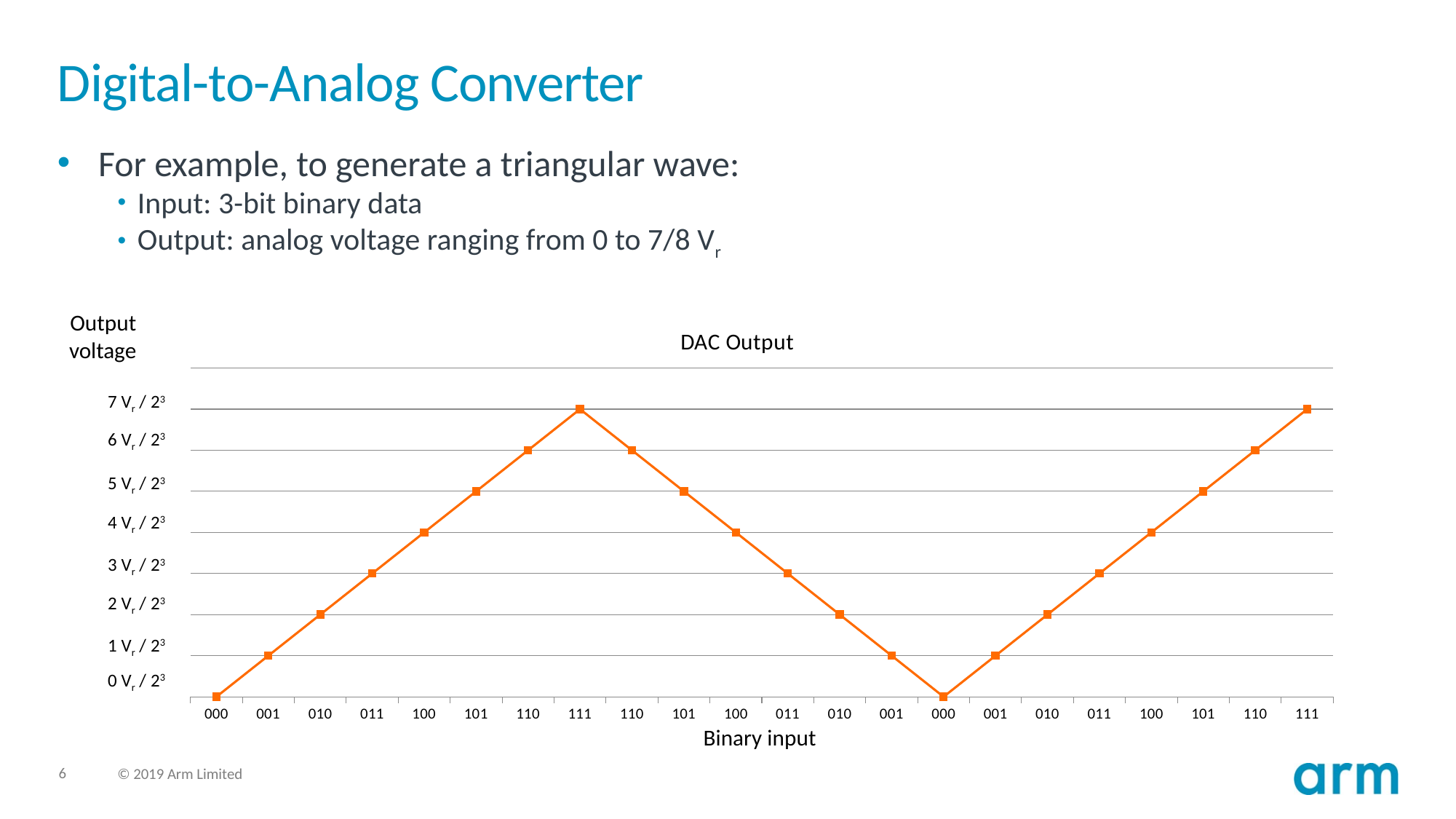
Which binary input gives the lowest output voltage on the DAC Output chart? 000 What output voltage does the binary input 000 produce on the DAC Output chart? 0 Vr / 2³ What output voltage does the binary input 100 produce on the DAC Output chart? 4 Vr / 2³ Which binary input produces a larger output voltage, 101 or 010? 101 What output voltage does the binary input 111 produce on the DAC Output chart? 7 Vr / 2³ What output voltage does the binary input 011 produce on the DAC Output chart? 3 Vr / 2³ What is the x-axis label of the DAC Output chart? Binary input Which binary input gives the highest output voltage on the DAC Output chart? 111 What is the title of the chart? DAC Output Does the output voltage rise or fall across the first eight binary inputs (000 to 111) on the DAC Output chart? rise How many data points are plotted on the DAC Output chart? 22 What kind of chart is the DAC Output chart? line chart